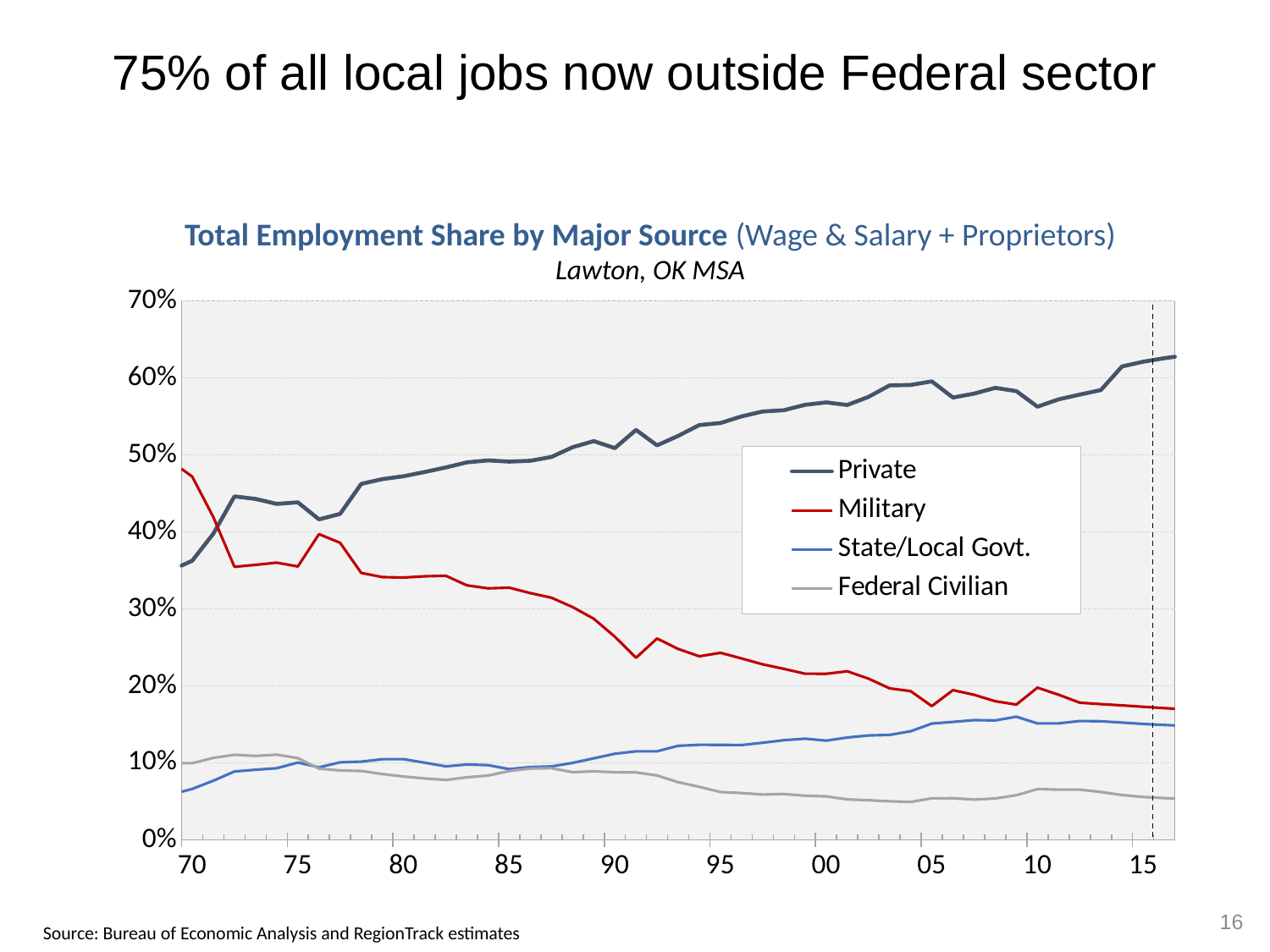
Is the value for Private in 2015 greater or less than 60%? greater How many series does the legend list? 4 Does the Private series rise or fall from 1970 to 2015? rise Is the value for Military in 1970 greater or less than 40%? greater Does the Military series rise or fall from 1970 to 2015? fall What colour is the Military line in the legend? red Is the value for Federal Civilian in 2015 greater or less than 10%? less Which series has the highest share in 1970? Military Which series has the lowest share in 2015? Federal Civilian In 2015, which is larger: State/Local Govt. or Federal Civilian? State/Local Govt. What kind of chart is shown on the slide? line chart